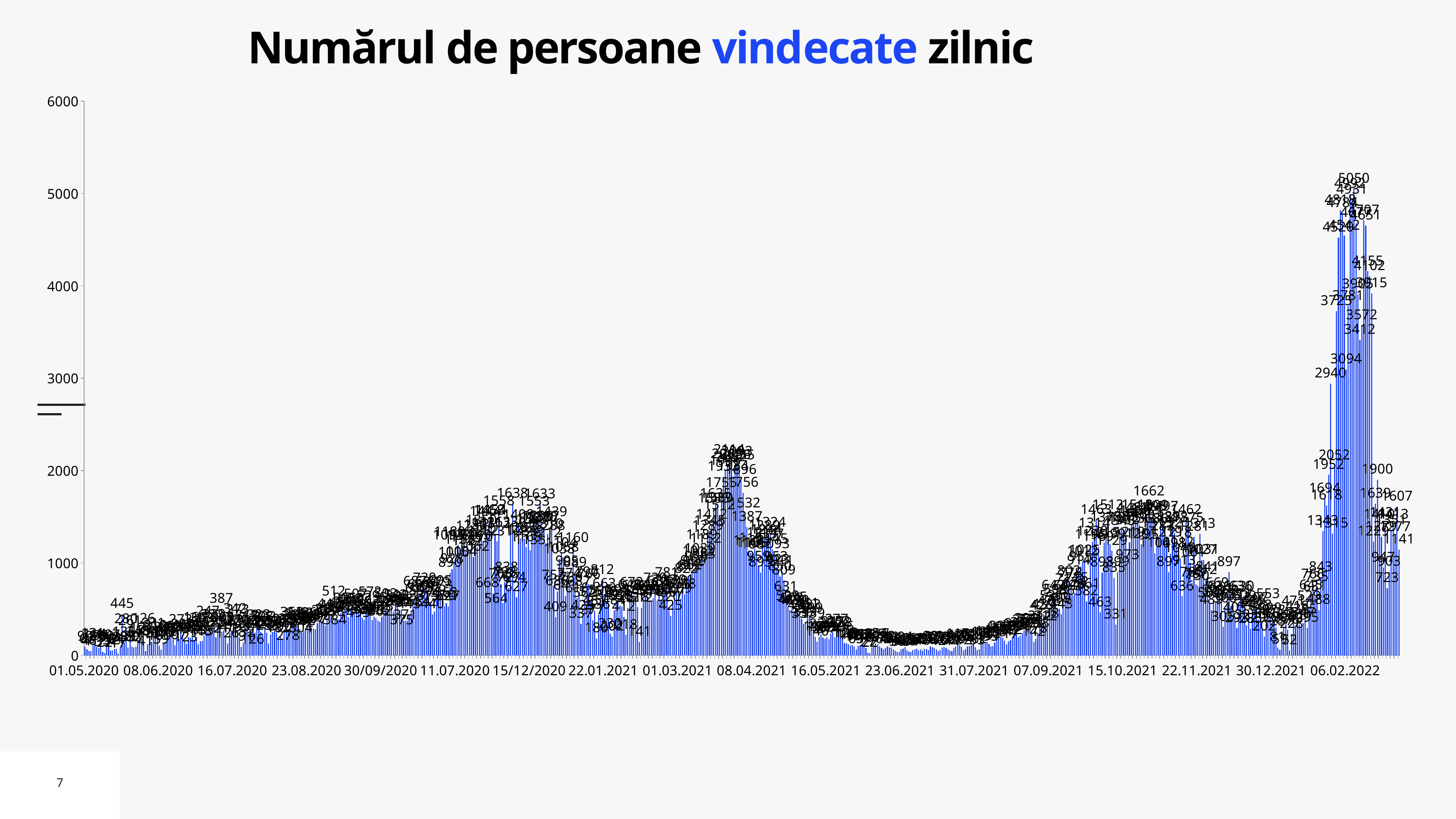
Which peak is higher: the one around 15/12/2020 or the one around 08.04.2021? 08.04.2021 Is the value for 15.10.2021 greater or less than 1000? greater Do the values rise or fall between 23.06.2021 and 15.10.2021? rise What colour are the bars in the chart? blue What is the highest data label shown on the chart? 5050 Is the value for 23.06.2021 greater or less than 500? less Is the highest value in the peak after 06.02.2022 greater or less than 4000? greater Which peak is higher: the one around 08.04.2021 or the one around 06.02.2022? 06.02.2022 Do the values rise or fall between 08.04.2021 and 23.06.2021? fall What is the title of the chart? Numărul de persoane vindecate zilnic What kind of chart is shown on the slide? bar chart